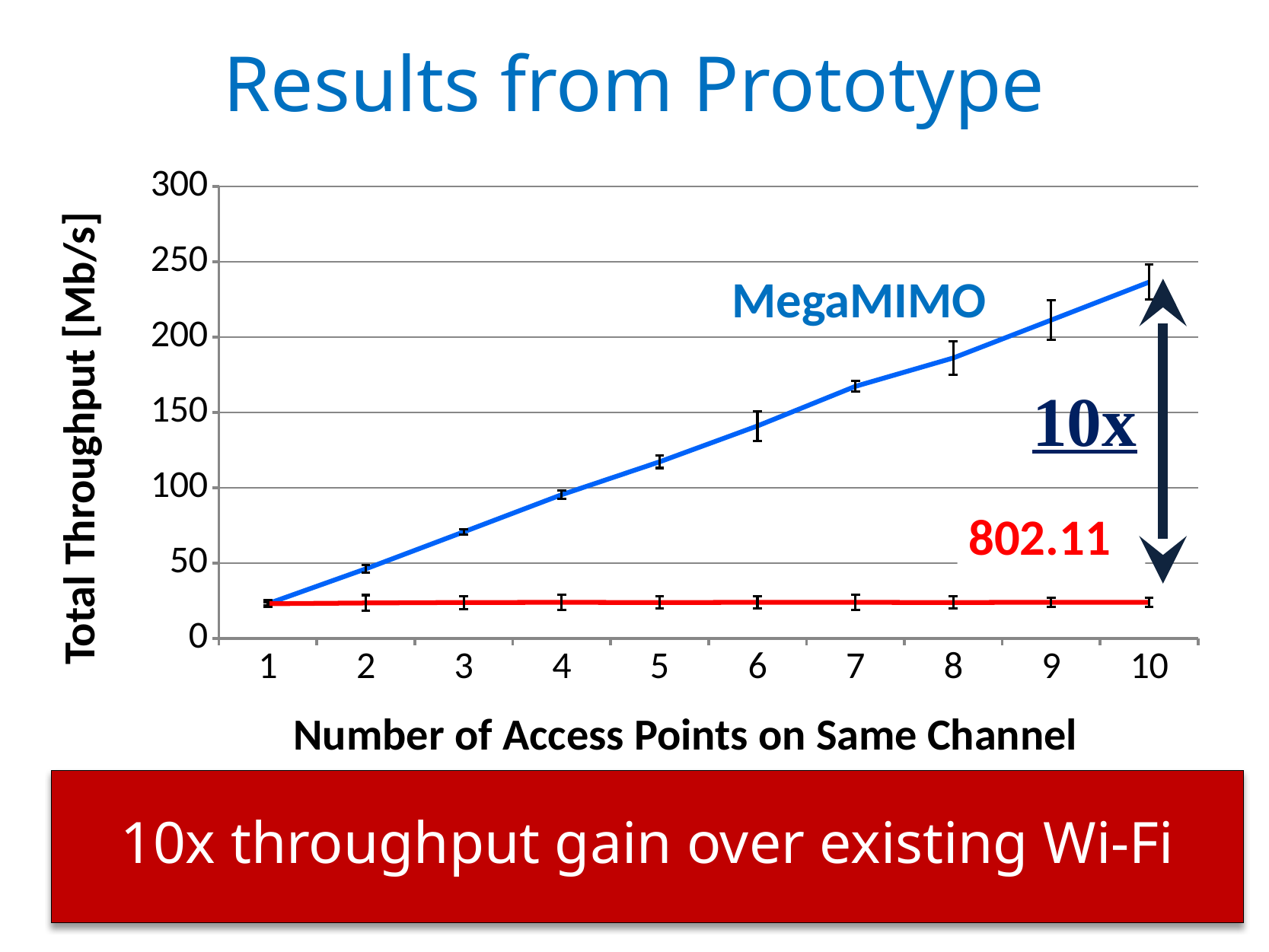
Is the 802.11 throughput at 10 access points greater or less than 50? less How many data series are plotted on the chart? 2 At which number of access points does MegaMIMO reach its highest throughput? 10 What kind of chart is shown on the slide? line chart How many points along the x axis (numbers of access points) are plotted? 10 Does the 802.11 throughput rise, fall, or stay roughly flat as the number of access points increases? stays roughly flat Is the MegaMIMO throughput at 7 access points greater or less than 150? greater Is the MegaMIMO throughput at 5 access points greater or less than 100? greater At 10 access points, which series has the higher throughput, MegaMIMO or 802.11? MegaMIMO Does the MegaMIMO throughput rise or fall as the number of access points increases? rises What is the label of the y axis? Total Throughput [Mb/s]